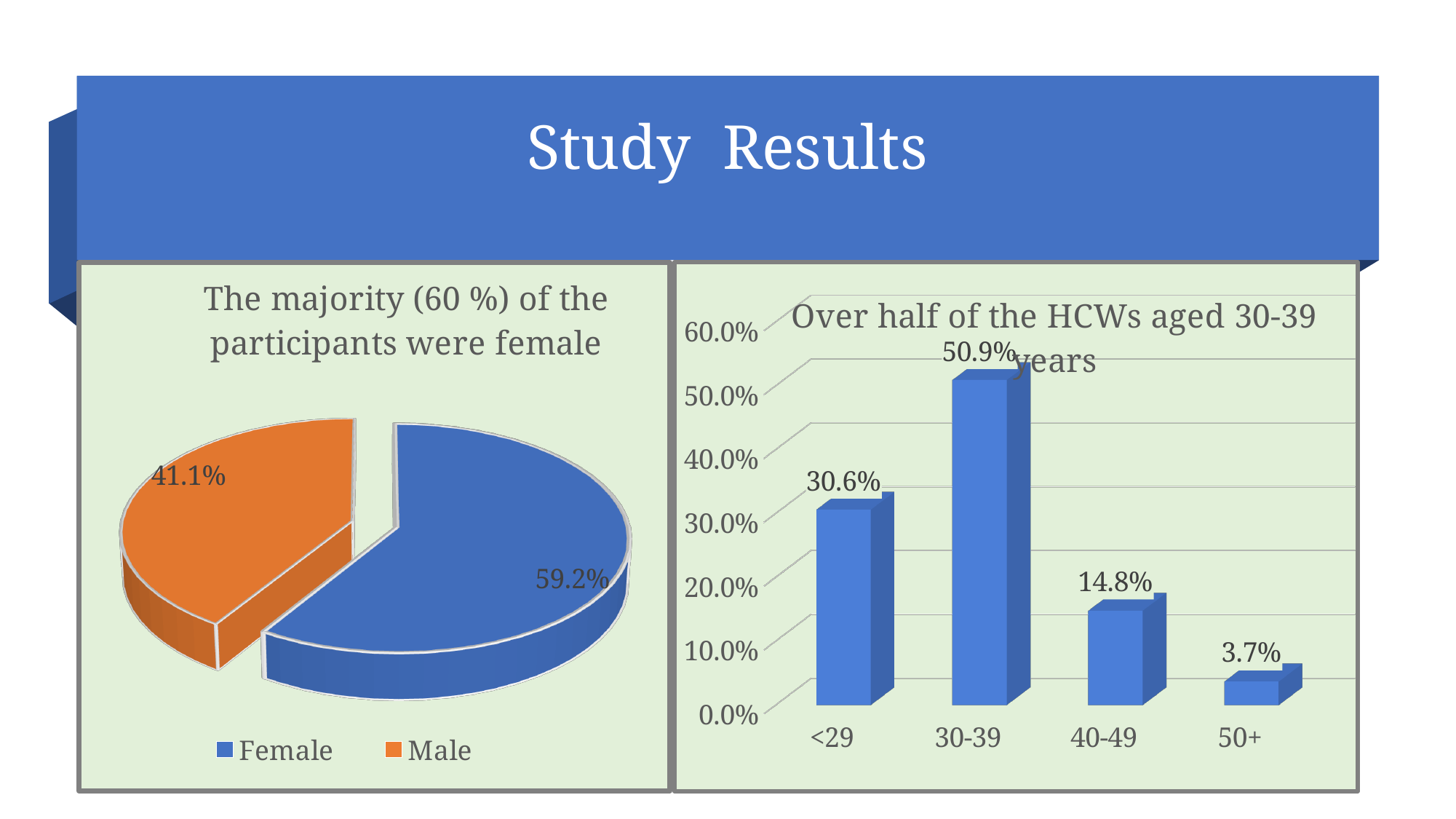
In the bar chart on the right, what is the value for the 30-39 age group? 50.9% In the bar chart on the right, what is the value for the 50+ age group? 3.7% In the bar chart on the right, which age group has the lowest value? 50+ In the pie chart on the left, how many entries does the legend list? 2 In the pie chart on the left, which category has the larger share, Female or Male? Female In the pie chart on the left, what colour is the Male slice? Orange In the bar chart on the right, how many age groups are shown on the x axis? 4 In the bar chart on the right, which age group has the highest value? 30-39 In the bar chart on the right, what is the difference between the values for <29 and 40-49? 15.8% What kind of chart is shown on the right side of the slide? Bar chart In the pie chart on the left, what percentage of participants were male? 41.1% In the pie chart on the left, what percentage of participants were female? 59.2%